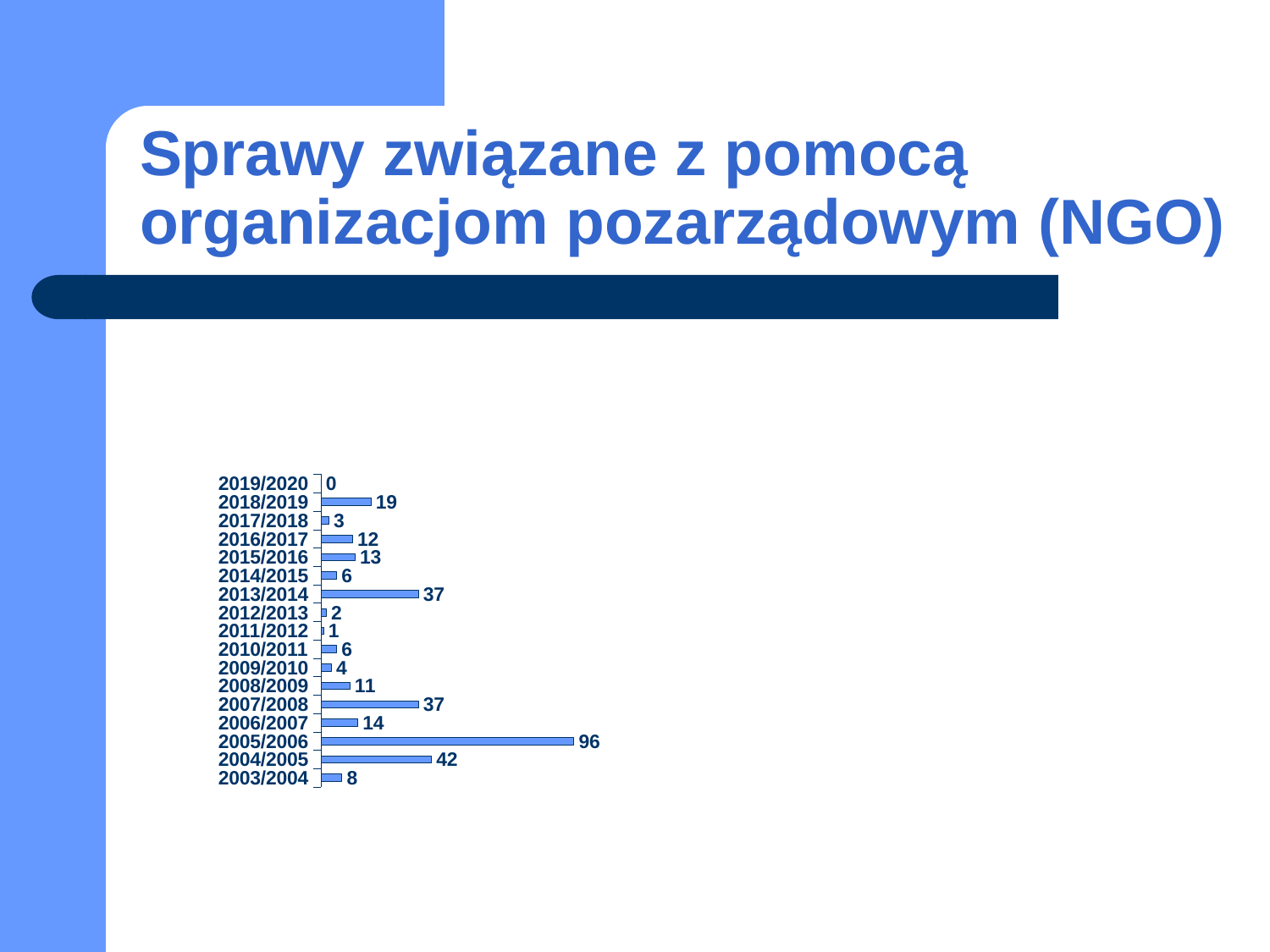
What is the difference between the values for 2006/2007 and 2003/2004? 6 How many years are shown in the chart? 17 What is the value for 2011/2012? 1 What is the value for 2018/2019? 19 What is the value for 2013/2014? 37 Which year has the highest value? 2005/2006 What is the difference between the values for 2005/2006 and 2004/2005? 54 What is the value for 2005/2006? 96 Which is larger, the value for 2008/2009 or the value for 2009/2010? 2008/2009 Which is larger, the value for 2016/2017 or the value for 2015/2016? 2015/2016 What kind of chart is shown on the slide? bar chart Which year has the lowest value? 2019/2020